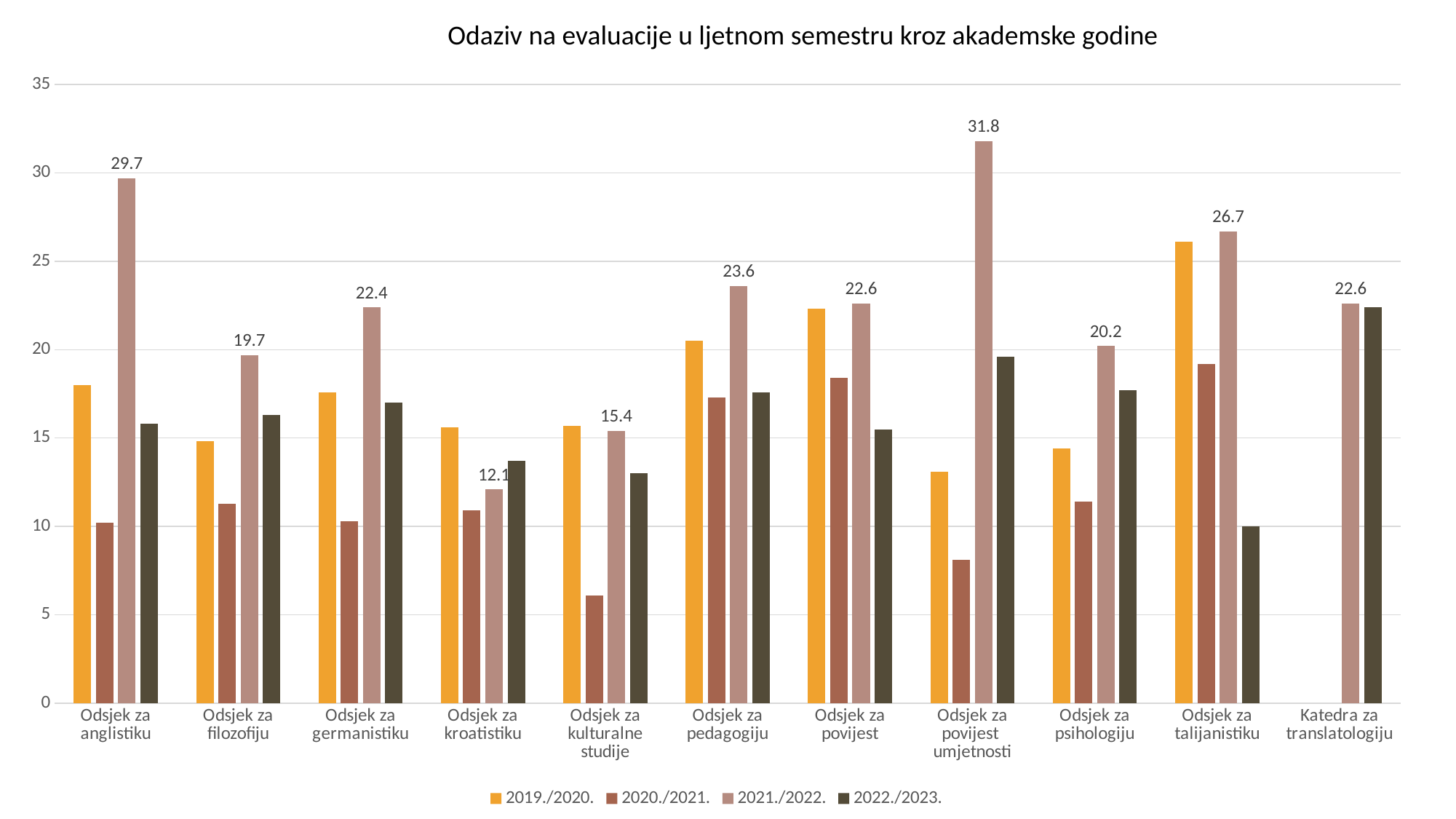
What is the value for Odsjek za psihologiju in the 2021./2022. series? 20.2 What is the value for Odsjek za anglistiku in the 2021./2022. series? 29.7 What is the difference between the 2021./2022. values for Odsjek za povijest umjetnosti and Odsjek za anglistiku? 2.1 Which category has the highest value in the 2021./2022. series? Odsjek za povijest umjetnosti Is the 2020./2021. value for Odsjek za kulturalne studije greater or less than 10? less Which category has the lowest value in the 2021./2022. series? Odsjek za kroatistiku How many categories are shown on the x axis? 11 What is the title of the chart? Odaziv na evaluacije u ljetnom semestru kroz akademske godine Is the 2019./2020. value for Odsjek za talijanistiku greater or less than 25? greater In the 2021./2022. series, which is larger: Odsjek za pedagogiju or Odsjek za germanistiku? Odsjek za pedagogiju What kind of chart is shown on the slide? bar chart How many series does the legend list? 4